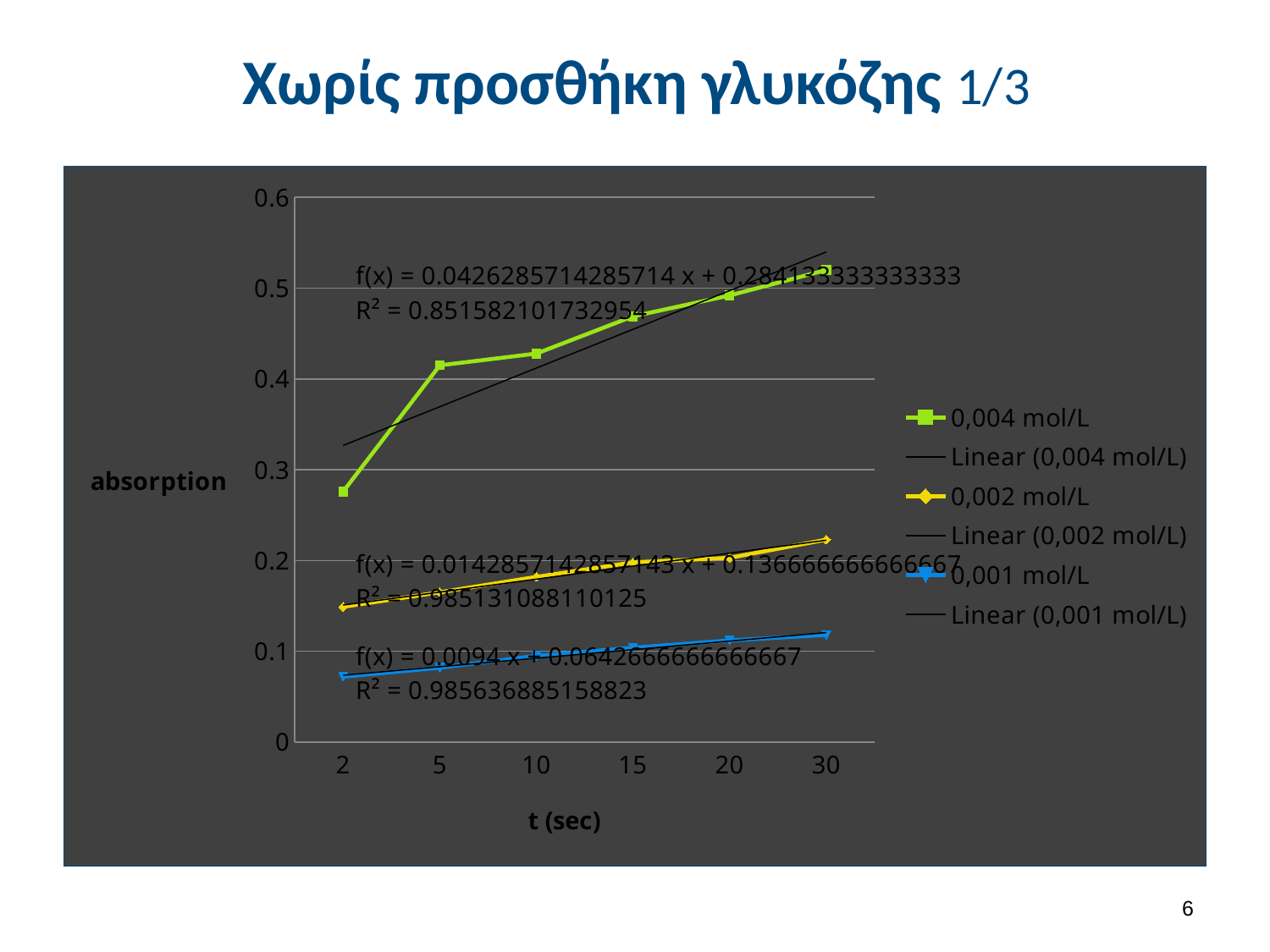
Which series has the highest absorption values across the chart? 0,004 mol/L What kind of chart is shown on the slide? line chart What is the label of the x axis of the chart? t (sec) How many entries does the chart legend list? 6 Does the absorption for the 0,004 mol/L series rise or fall as t (sec) increases? rises At t = 10 sec, which series has the larger absorption: 0,004 mol/L or 0,002 mol/L? 0,004 mol/L What R² value is printed for the 0,001 mol/L trendline? 0.985636885158823 How many time points are shown on the x axis of the chart? 6 Is the absorption for 0,004 mol/L at t = 30 sec greater or less than 0.5? greater Is the absorption for 0,001 mol/L at t = 2 sec greater or less than 0.1? less Which series has the lowest absorption values across the chart? 0,001 mol/L Is the absorption for 0,004 mol/L at t = 2 sec greater or less than 0.3? less